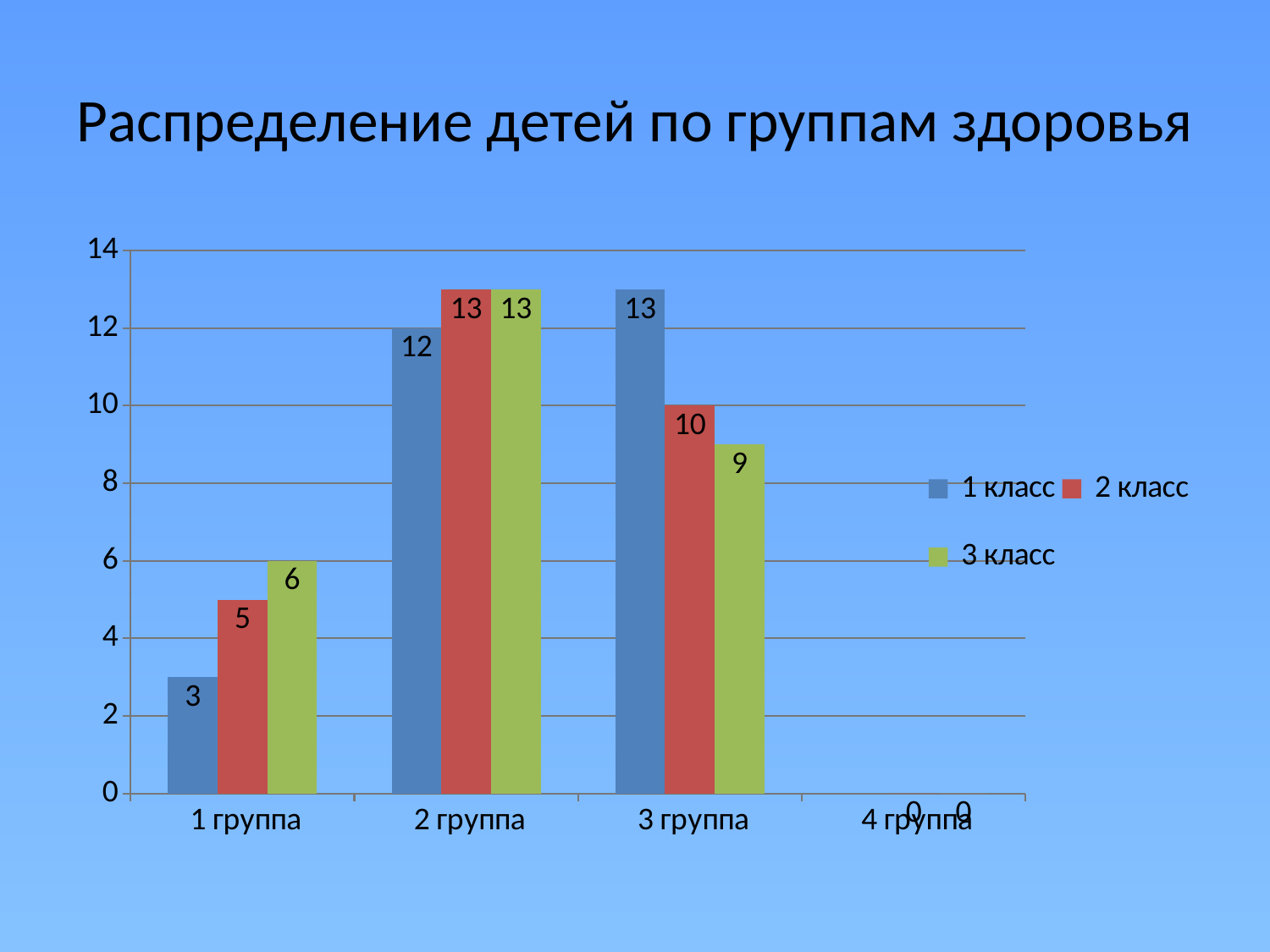
What is the title of the chart? Распределение детей по группам здоровья In 1 группа, which is larger: the value for 2 класс or for 3 класс? 3 класс How many series does the legend list? 3 Which category has the lowest value for 2 класс among 1, 2 and 3 группа? 1 группа What type of chart is shown on the slide? bar chart What is the value for 2 класс in 2 группа? 13 What is the difference between the 1 класс and 3 класс values in 3 группа? 4 How many categories are shown on the x axis? 4 What is the value for 3 класс in 3 группа? 9 Is the value for 1 класс in 2 группа greater or less than 10? greater What is the value for 1 класс in 1 группа? 3 Which category has the highest value for 1 класс? 3 группа